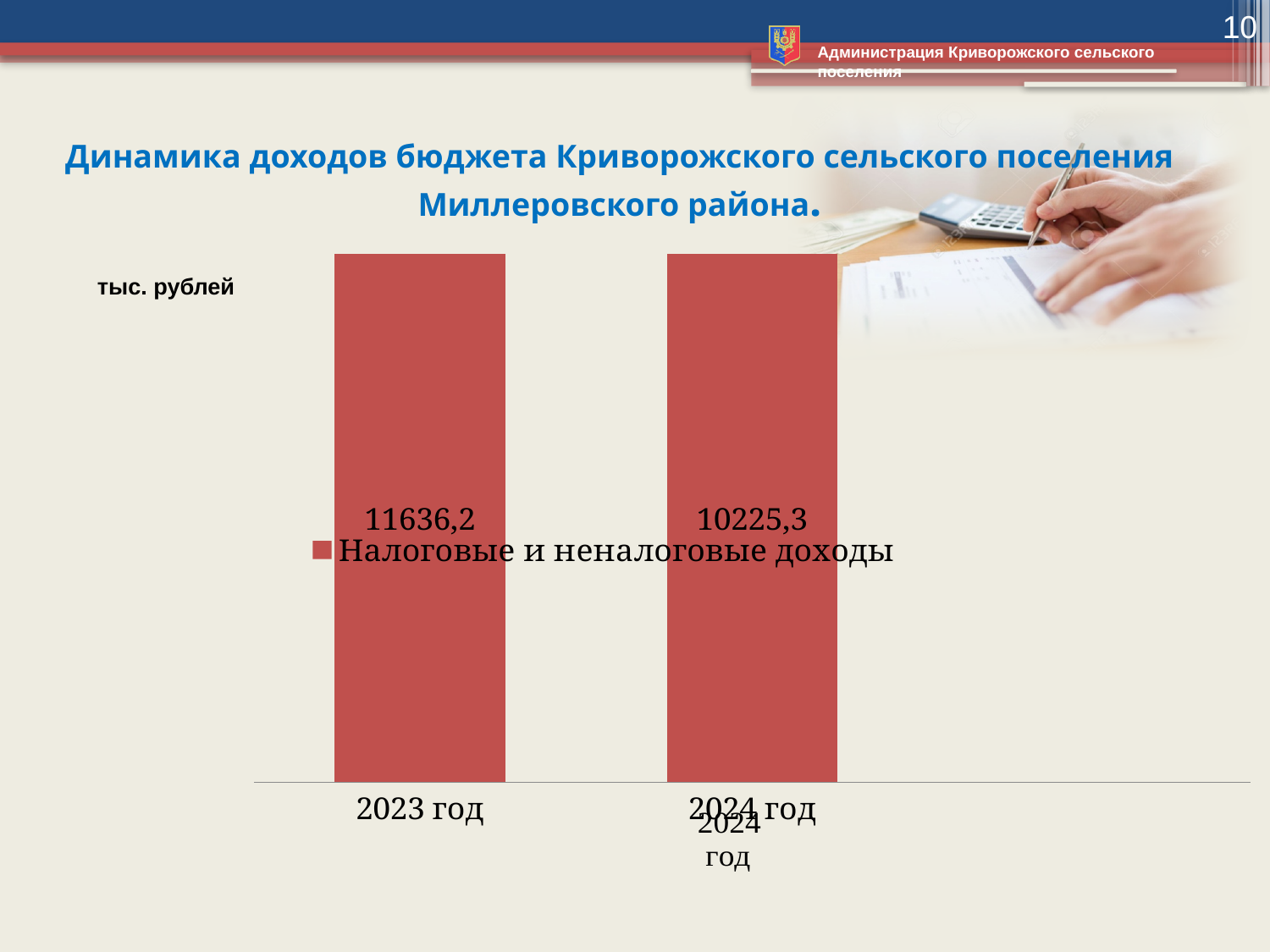
Which is larger, the value for 2023 год or the value for 2024 год? 2023 год What is the difference between the values for 2023 год and 2024 год? 1410,9 In what units are the chart values given? тыс. рублей Which year has the highest value? 2023 год How many categories (years) are shown on the chart? 2 Which year has the lowest value? 2024 год What is the value for 2024 год? 10225,3 Do the values rise or fall from 2023 год to 2024 год? fall What is the value for 2023 год? 11636,2 What kind of chart is shown on the slide? bar chart How many series does the legend list? 1 What series name is shown in the chart legend? Налоговые и неналоговые доходы